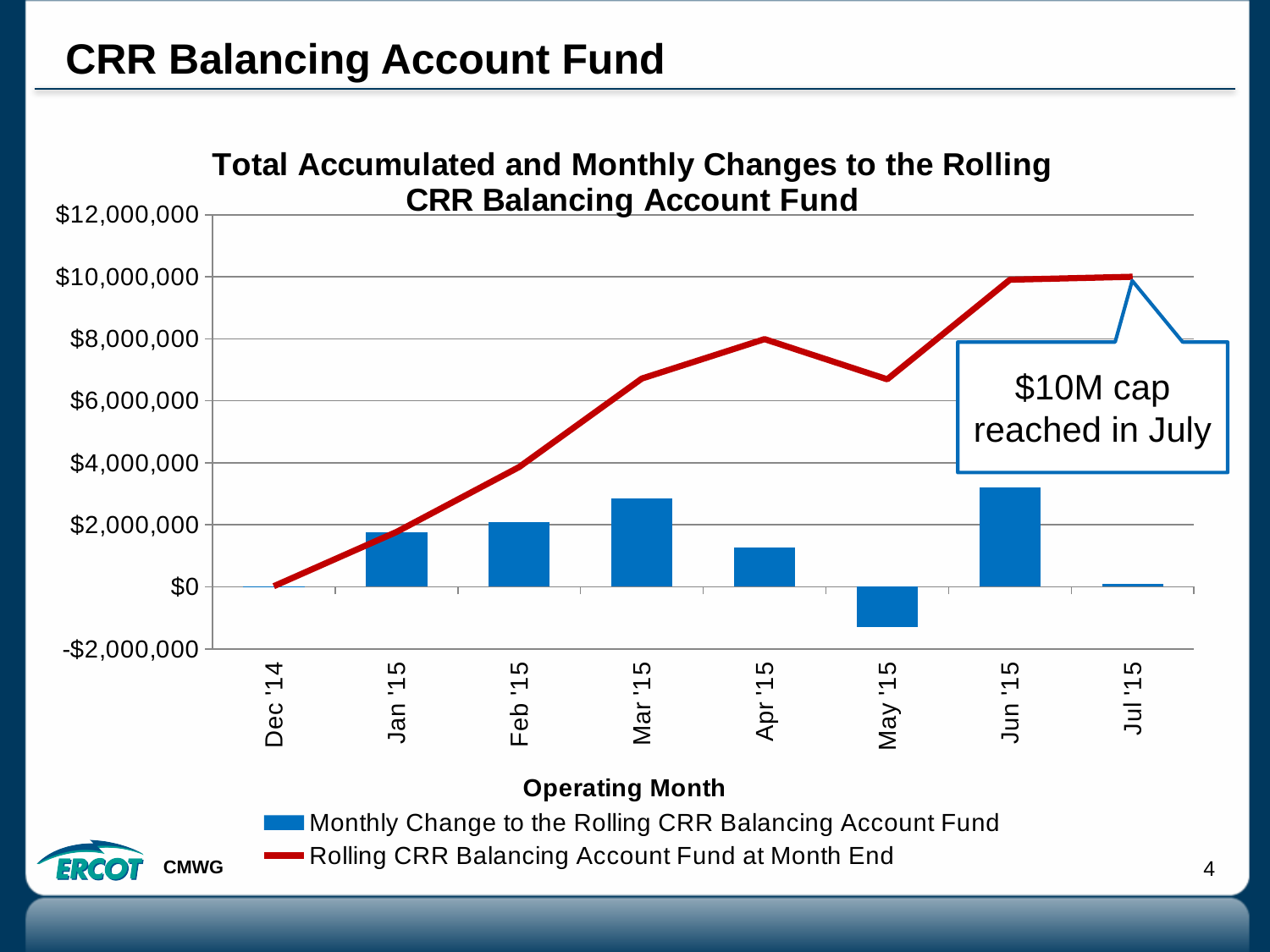
According to the callout on the chart, in which month was the $10M cap reached? July Which is larger, the Monthly Change to the Rolling CRR Balancing Account Fund for Jun '15 or for Mar '15? Jun '15 Is the Monthly Change to the Rolling CRR Balancing Account Fund for Mar '15 greater or less than $2,000,000? greater Does the Rolling CRR Balancing Account Fund at Month End rise or fall from Apr '15 to May '15? Fall How many operating months are shown on the x axis? 8 Which operating month has the highest Monthly Change to the Rolling CRR Balancing Account Fund? Jun '15 Is the Rolling CRR Balancing Account Fund at Month End for Jun '15 greater or less than $8,000,000? greater Is the Rolling CRR Balancing Account Fund at Month End for Mar '15 greater or less than $6,000,000? greater How many series does the legend list? 2 What kind of chart is shown on the slide? A combined bar and line chart Which operating month has the lowest Monthly Change to the Rolling CRR Balancing Account Fund? May '15